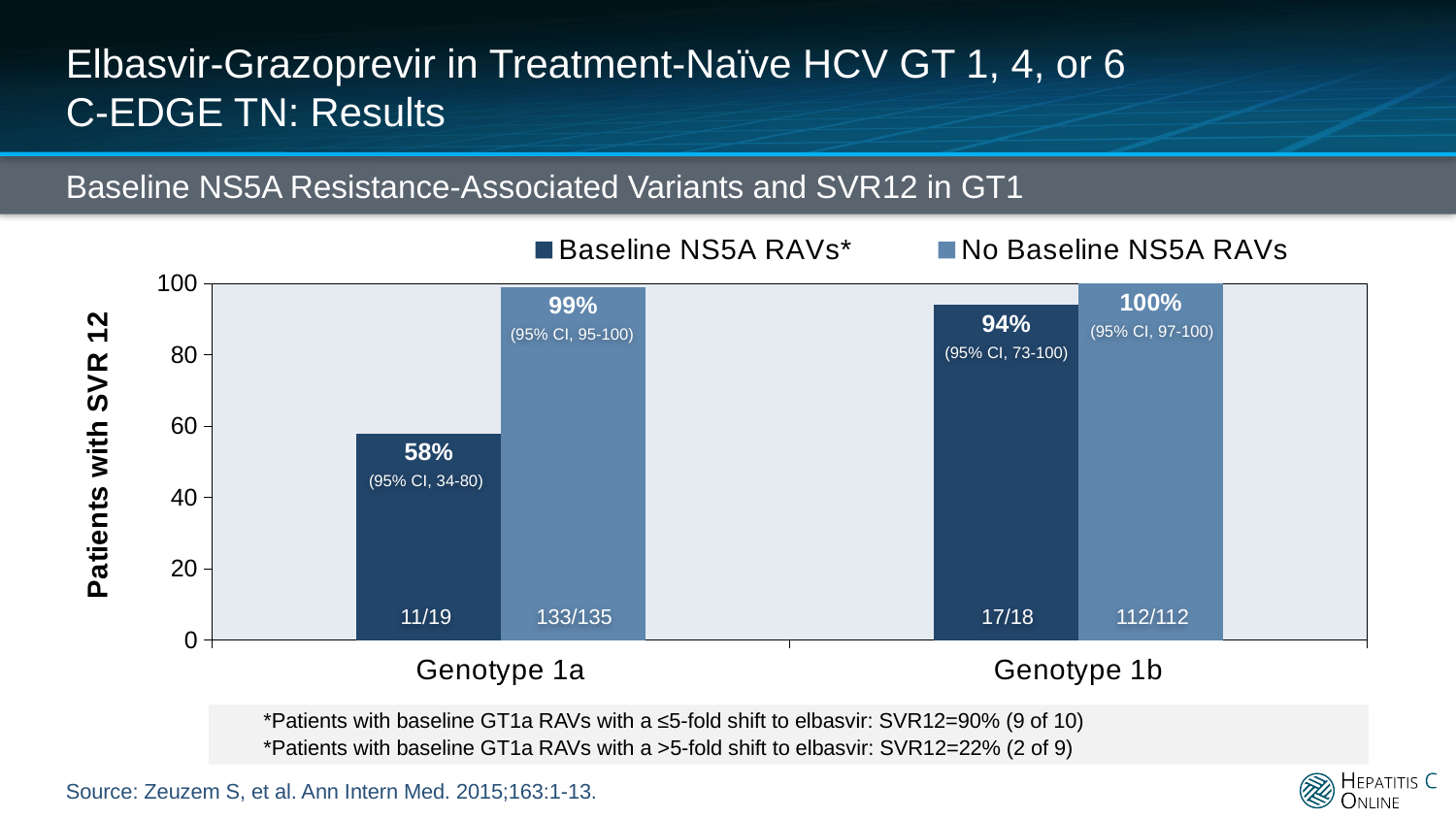
How many genotype categories are shown on the x axis? 2 What is the SVR12 rate for patients with no baseline NS5A RAVs in Genotype 1b? 100% Which is larger: the SVR12 rate for baseline NS5A RAVs in Genotype 1a or in Genotype 1b? Genotype 1b What fraction of patients is shown for the No Baseline NS5A RAVs bar in Genotype 1a? 133/135 How many series does the legend list? 2 What is the SVR12 rate for patients with baseline NS5A RAVs in Genotype 1b? 94% Which bar has the highest SVR12 rate on the chart? No Baseline NS5A RAVs, Genotype 1b What is the SVR12 rate for patients with baseline NS5A RAVs in Genotype 1a? 58% What type of chart is shown on the slide? Bar chart Which bar has the lowest SVR12 rate on the chart? Baseline NS5A RAVs, Genotype 1a What is the difference in SVR12 rate between patients with and without baseline NS5A RAVs in Genotype 1b? 6% What is the difference in SVR12 rate between patients with and without baseline NS5A RAVs in Genotype 1a? 41%